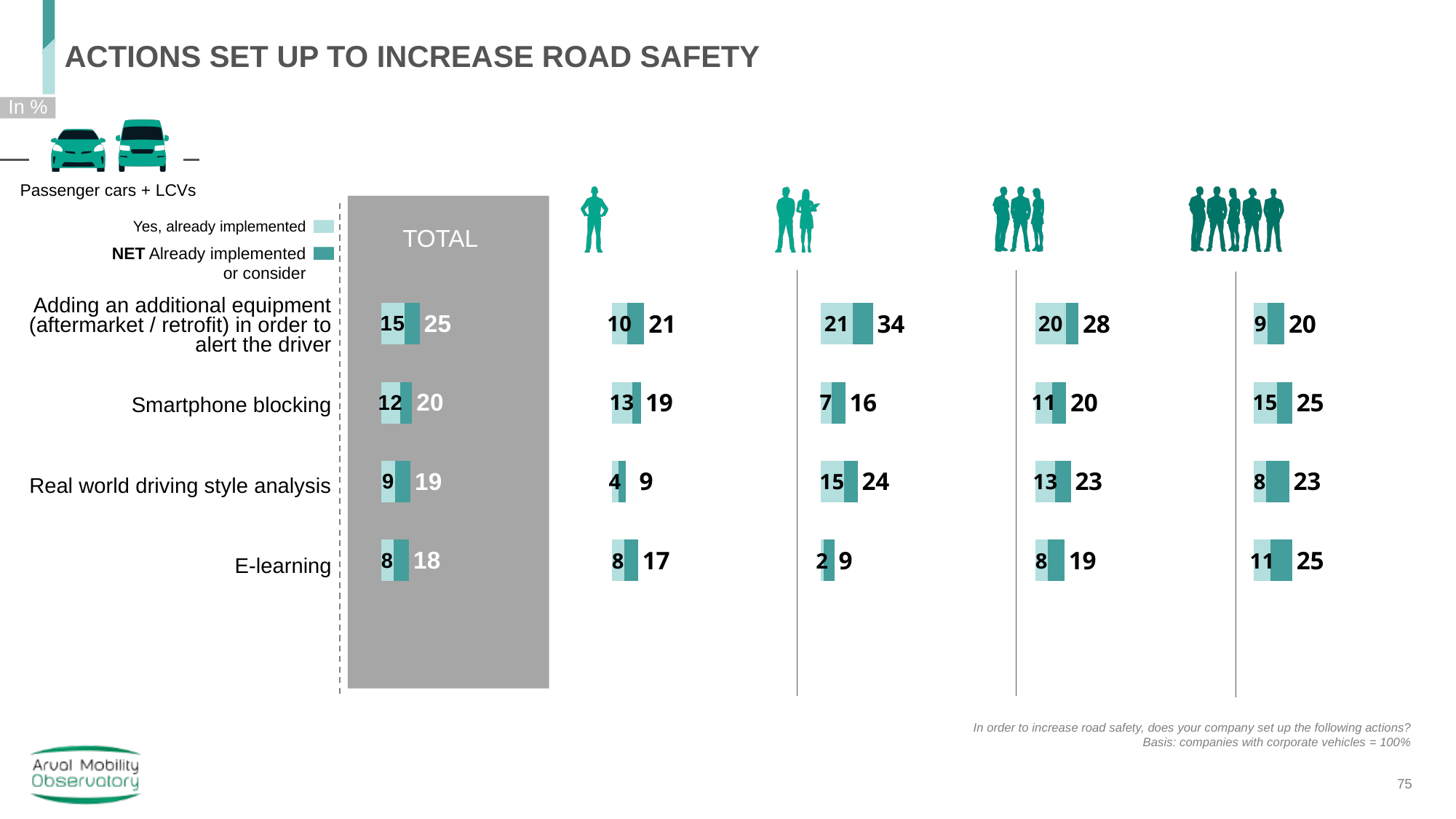
In the rightmost column of the chart, what is the NET 'Already implemented or consider' value for E-learning? 25 In what unit are the values on the chart expressed? % In the TOTAL column, what is the 'Yes, already implemented' value for Smartphone blocking? 12 In the TOTAL column, which action has the lowest 'Yes, already implemented' value? E-learning In the TOTAL column, what is the difference between the NET values for Adding an additional equipment and Smartphone blocking? 5 In the TOTAL column, what is the NET 'Already implemented or consider' value for Real world driving style analysis? 19 In the TOTAL column, what is the NET 'Already implemented or consider' value for E-learning? 18 In the TOTAL column, which has the larger 'Yes, already implemented' value: Smartphone blocking or Real world driving style analysis? Smartphone blocking What kind of chart is shown on the slide? Bar chart How many series does the legend list? 2 How many road safety actions are listed on the chart? 4 In the TOTAL column, which action has the highest NET 'Already implemented or consider' value? Adding an additional equipment (aftermarket / retrofit) in order to alert the driver